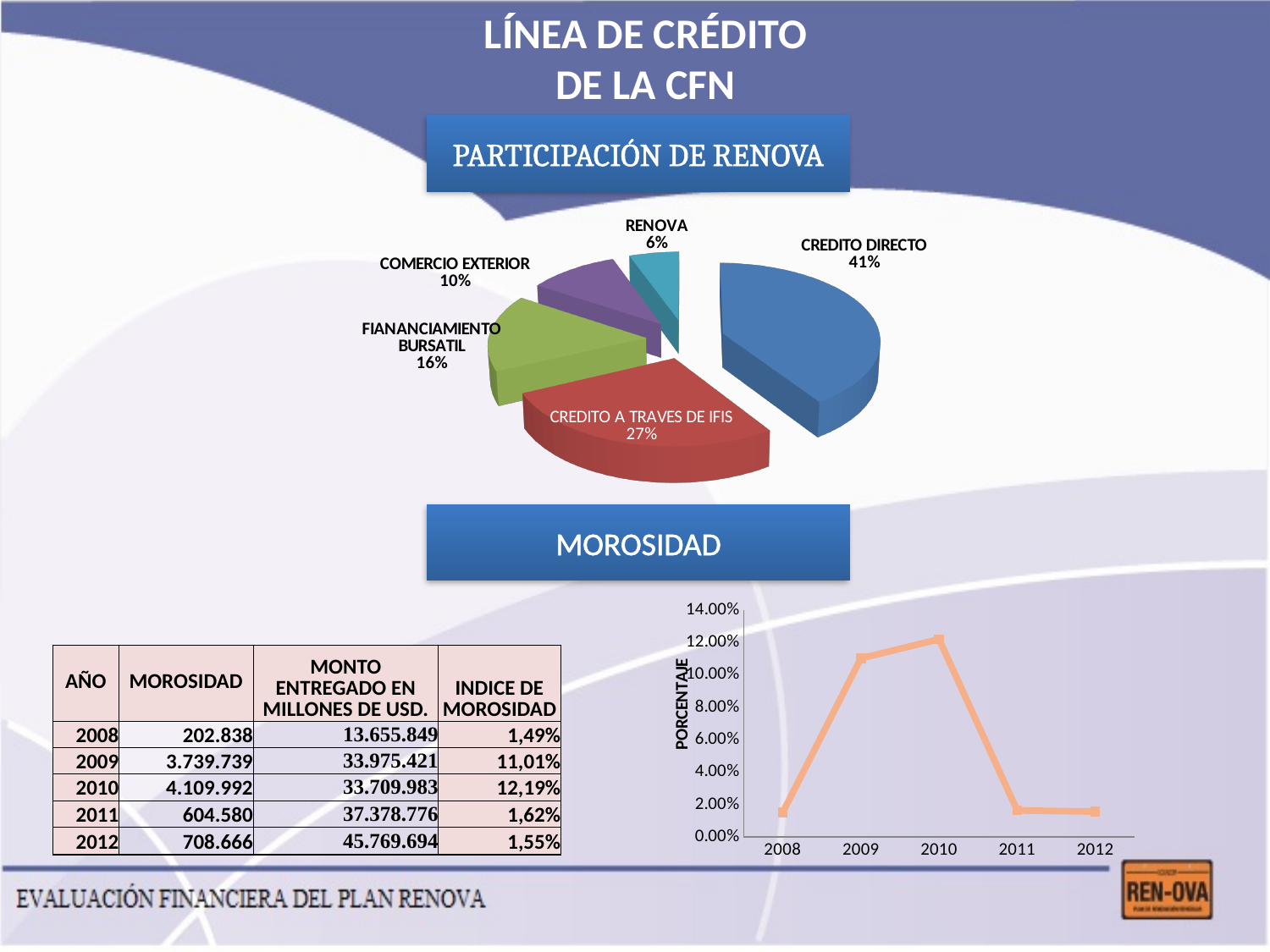
On the PARTICIPACIÓN DE RENOVA chart, how many slices does the pie have? 5 On the PARTICIPACIÓN DE RENOVA chart, what share does CREDITO A TRAVES DE IFIS have? 27% On the MOROSIDAD chart, which year has the highest value? 2010 On the MOROSIDAD chart, what kind of chart is shown? line chart On the MOROSIDAD chart, does the line rise or fall from 2010 to 2011? fall On the PARTICIPACIÓN DE RENOVA chart, what share does RENOVA have? 6% On the PARTICIPACIÓN DE RENOVA chart, which category has the smallest slice? RENOVA On the MOROSIDAD chart, is the value for 2009 greater or less than 10.00%? greater On the PARTICIPACIÓN DE RENOVA chart, which is larger, FIANANCIAMIENTO BURSATIL or COMERCIO EXTERIOR? FIANANCIAMIENTO BURSATIL On the PARTICIPACIÓN DE RENOVA chart, what is the difference in percentage points between CREDITO DIRECTO and CREDITO A TRAVES DE IFIS? 14 percentage points On the PARTICIPACIÓN DE RENOVA chart, which category has the largest slice? CREDITO DIRECTO On the PARTICIPACIÓN DE RENOVA chart, what kind of chart is shown? pie chart